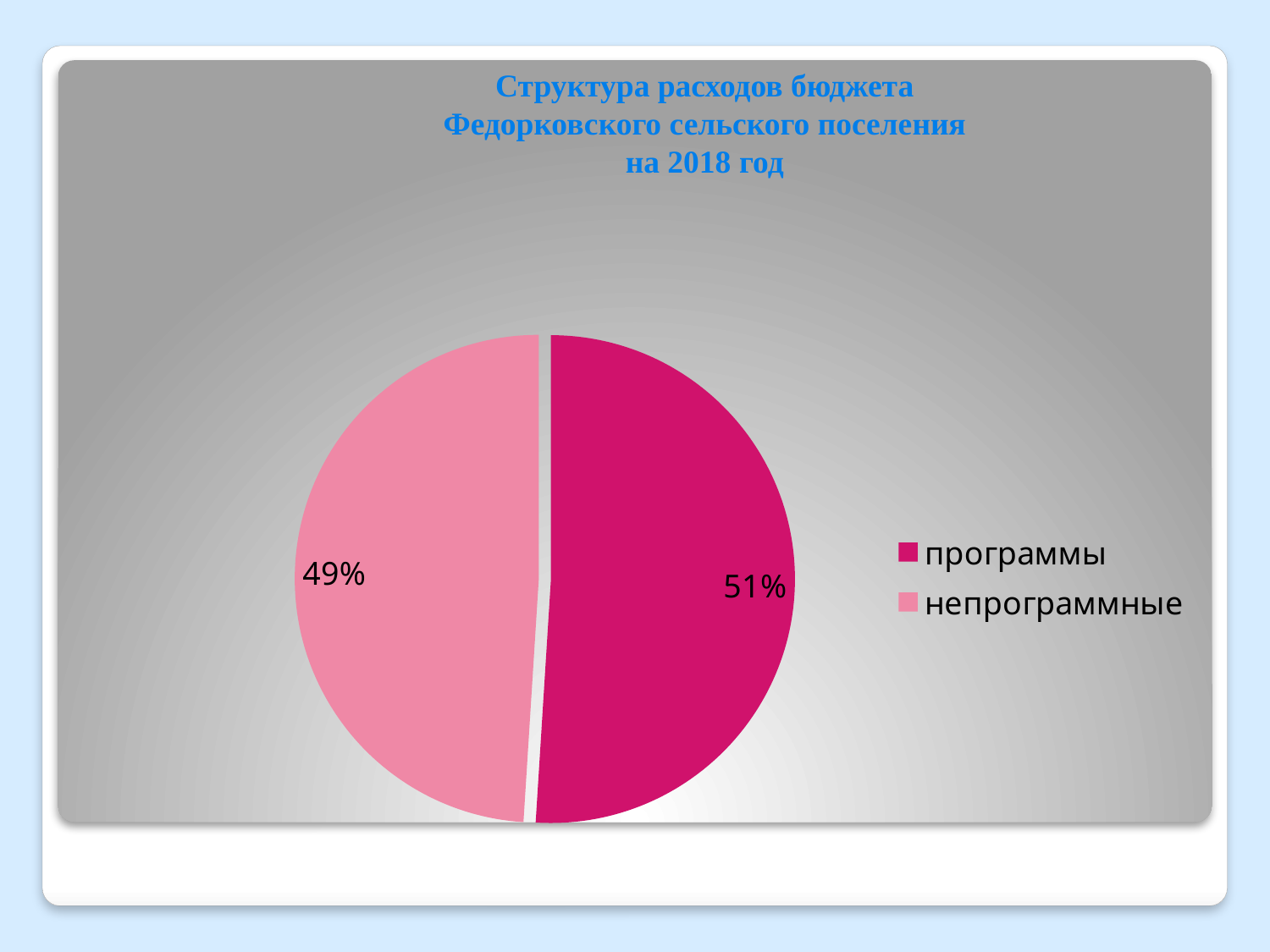
Which is larger, the "программы" slice or the "непрограммные" slice? программы Which legend entry is shown in the darker magenta colour? программы What kind of chart is shown on the slide? pie chart How many entries does the legend list? 2 What share of the pie does the "программы" slice represent? 51% Which category has the largest slice of the pie? программы What share of the pie does the "непрограммные" slice represent? 49% What is the difference in percentage points between the "программы" and "непрограммные" slices? 2% How many slices does the pie chart have? 2 Which category has the smallest slice of the pie? непрограммные What is the title of the chart? Структура расходов бюджета Федорковского сельского поселения на 2018 год